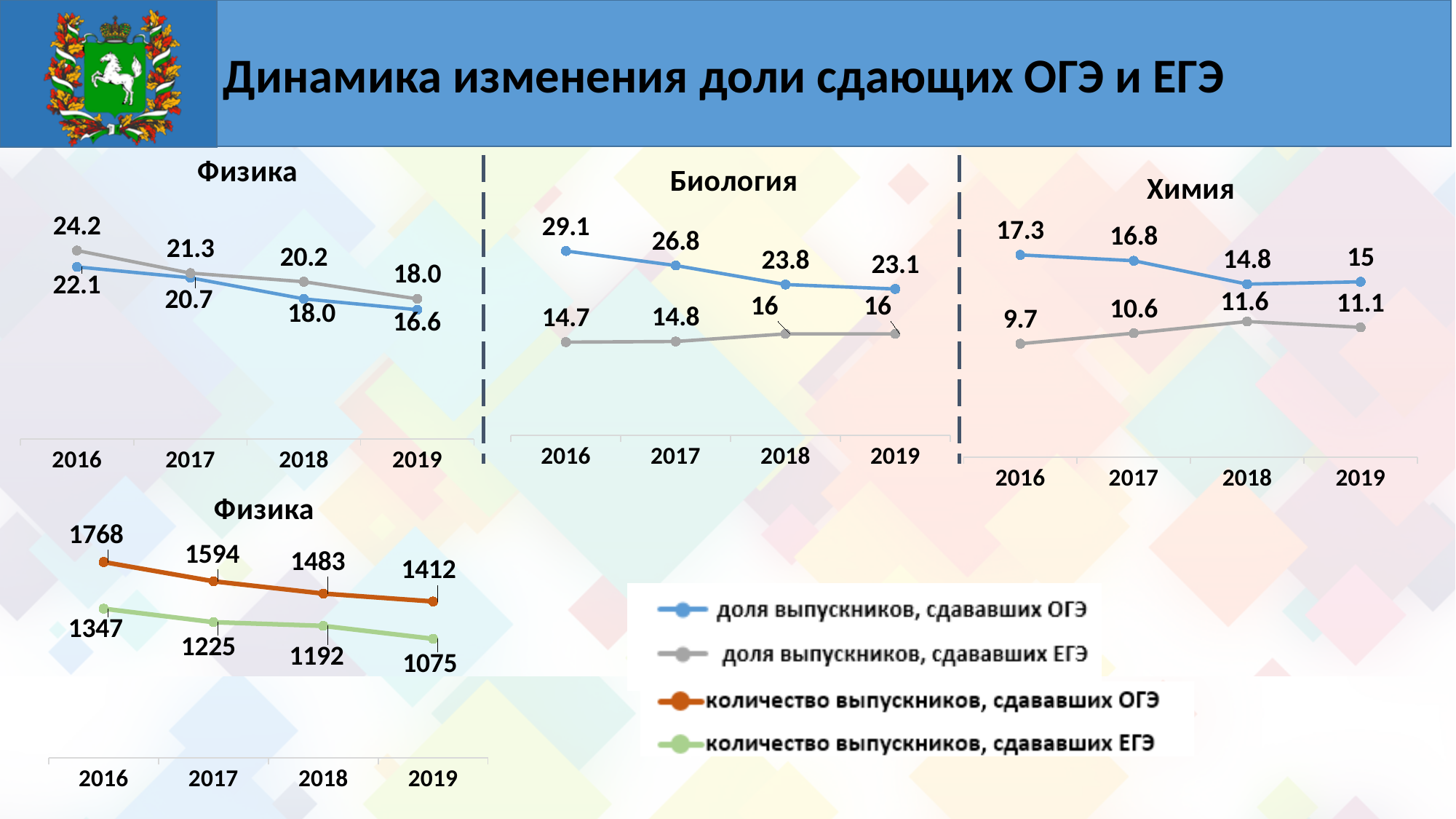
In the 'Биология' chart, does the share of graduates who took ОГЭ rise or fall from 2016 to 2019? fall In the 'Биология' chart, in which year is the share of graduates who took ОГЭ highest? 2016 In the top-left 'Физика' chart, what is the share of graduates who took ОГЭ in 2016? 22.1 In the top-left 'Физика' chart, which is larger in 2017: the share of graduates who took ОГЭ or the share who took ЕГЭ? доля выпускников, сдававших ЕГЭ In the bottom-left 'Физика' chart, how many graduates took ЕГЭ in 2017? 1225 In the bottom-left 'Физика' chart, what is the difference between the number of graduates who took ОГЭ and the number who took ЕГЭ in 2016? 421 What type of chart is the 'Биология' chart? line chart How many series does the legend on the slide list? 4 In the 'Химия' chart, in which year is the share of graduates who took ЕГЭ lowest? 2016 In the 'Химия' chart, what is the share of graduates who took ОГЭ in 2018? 14.8 How many years are shown on the x axis of the 'Химия' chart? 4 In the 'Биология' chart, what is the share of graduates who took ЕГЭ in 2019? 16